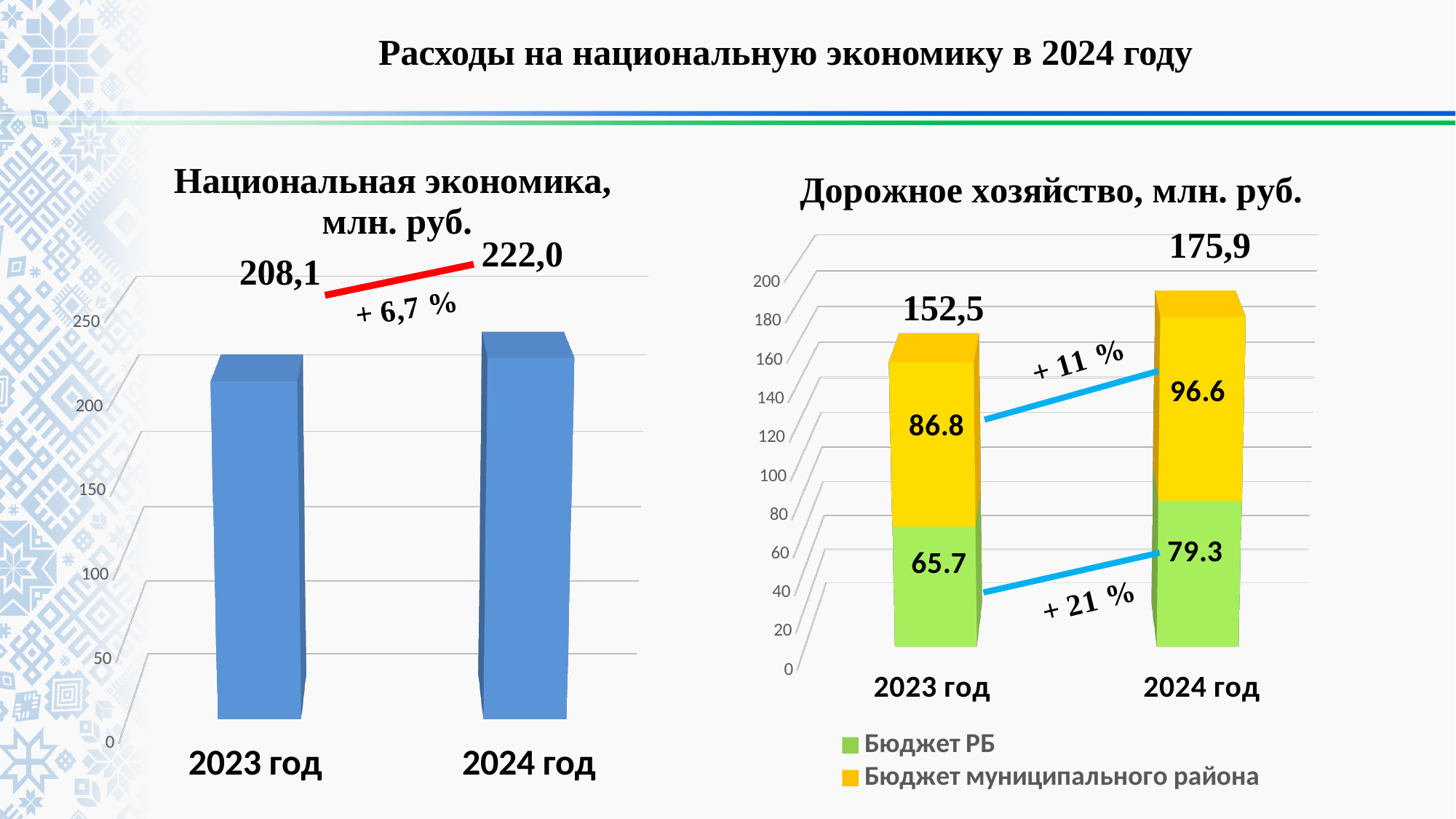
In the chart titled "Дорожное хозяйство, млн. руб.", what is the total of the stacked bar for 2023 год? 152,5 In the chart titled "Дорожное хозяйство, млн. руб.", what is the total of the stacked bar for 2024 год? 175,9 In the chart titled "Национальная экономика, млн. руб.", do the values rise or fall from 2023 год to 2024 год? rise In the chart titled "Дорожное хозяйство, млн. руб.", what is the difference between the Бюджет РБ values for 2024 год and 2023 год? 13.6 In the chart titled "Национальная экономика, млн. руб.", what is the value for 2024 год? 222,0 In the chart titled "Дорожное хозяйство, млн. руб.", what is the value of Бюджет РБ for 2023 год? 65.7 In the chart titled "Дорожное хозяйство, млн. руб.", which is larger for 2023 год: Бюджет РБ or Бюджет муниципального района? Бюджет муниципального района In the chart titled "Национальная экономика, млн. руб.", what is the value for 2023 год? 208,1 In the chart titled "Дорожное хозяйство, млн. руб.", what is the value of Бюджет муниципального района for 2024 год? 96.6 In the chart titled "Национальная экономика, млн. руб.", what kind of chart is shown? bar chart In the chart titled "Национальная экономика, млн. руб.", what percentage change is shown between 2023 год and 2024 год? + 6,7 % In the chart titled "Дорожное хозяйство, млн. руб.", how many series does the legend list? 2